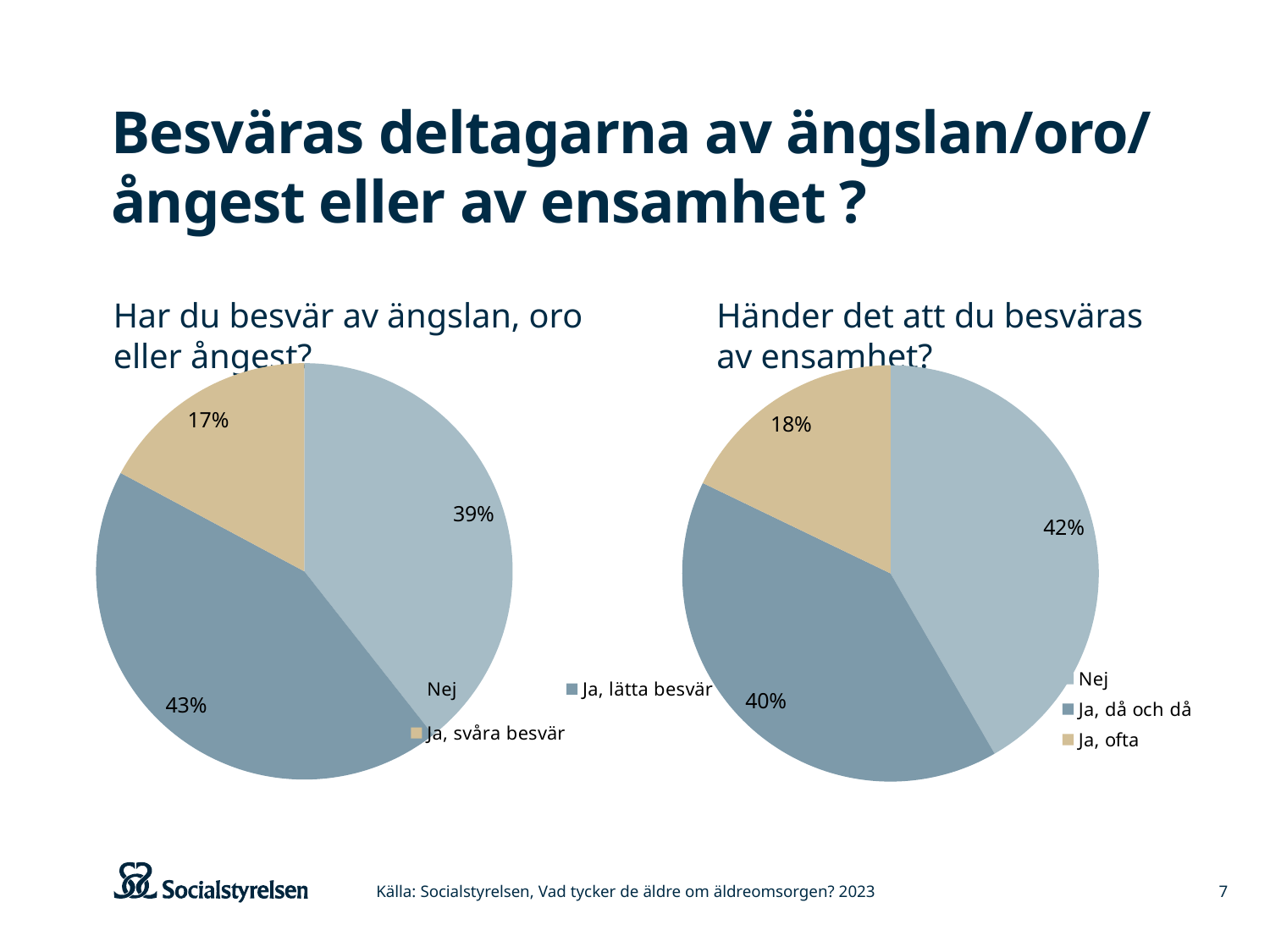
In the left chart 'Har du besvär av ängslan, oro eller ångest?', what is the difference in percentage points between 'Ja, lätta besvär' and 'Ja, svåra besvär'? 26 percentage points In the right chart 'Händer det att du besväras av ensamhet?', which is larger: 'Nej' or 'Ja, ofta'? Nej In the right chart 'Händer det att du besväras av ensamhet?', which answer is shown in the tan/beige colour? Ja, ofta How many slices does the right chart 'Händer det att du besväras av ensamhet?' have? 3 In the left chart 'Har du besvär av ängslan, oro eller ångest?', what share answered 'Nej'? 39% In the right chart 'Händer det att du besväras av ensamhet?', what share answered 'Ja, ofta'? 18% In the left chart 'Har du besvär av ängslan, oro eller ångest?', what share answered 'Ja, svåra besvär'? 17% In the left chart 'Har du besvär av ängslan, oro eller ångest?', what share answered 'Ja, lätta besvär'? 43% In the right chart 'Händer det att du besväras av ensamhet?', what share answered 'Ja, då och då'? 40% In the left chart 'Har du besvär av ängslan, oro eller ångest?', which answer has the smallest share? Ja, svåra besvär What type of chart is used for 'Har du besvär av ängslan, oro eller ångest?'? Pie chart In the right chart 'Händer det att du besväras av ensamhet?', which answer has the largest share? Nej